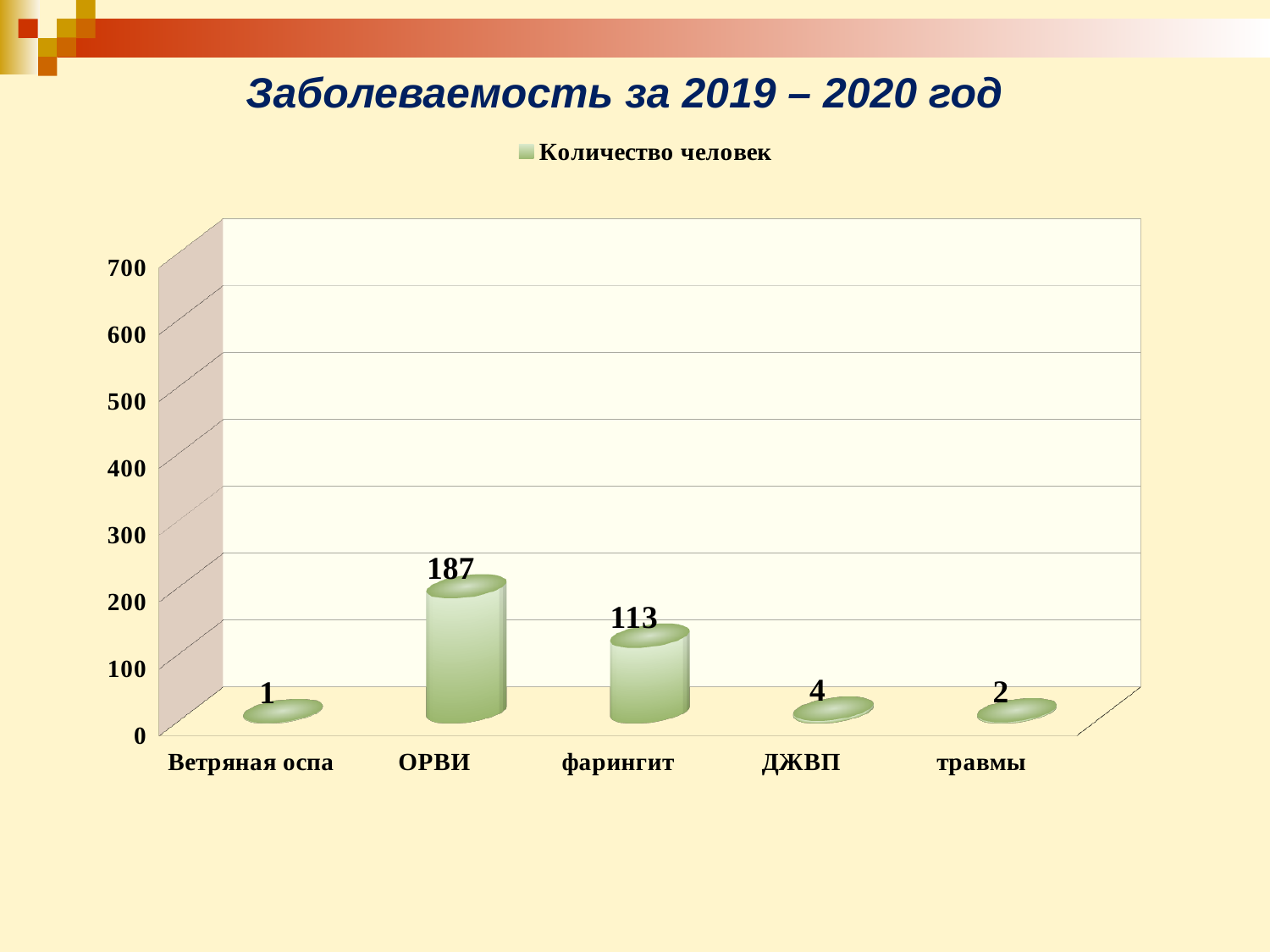
What kind of chart is shown on the slide? bar chart What is the difference between the values for ОРВИ and фарингит? 74 Which is larger, the value for ДЖВП or the value for травмы? ДЖВП What is the title of the chart? Заболеваемость за 2019 – 2020 год Which category has the lowest value? Ветряная оспа What is the value for ОРВИ? 187 Which category has the highest value? ОРВИ How many categories are shown on the x axis? 5 What is the value for Ветряная оспа? 1 Is the value for ОРВИ greater or less than 200? less What is the value for ДЖВП? 4 What is the value for фарингит? 113